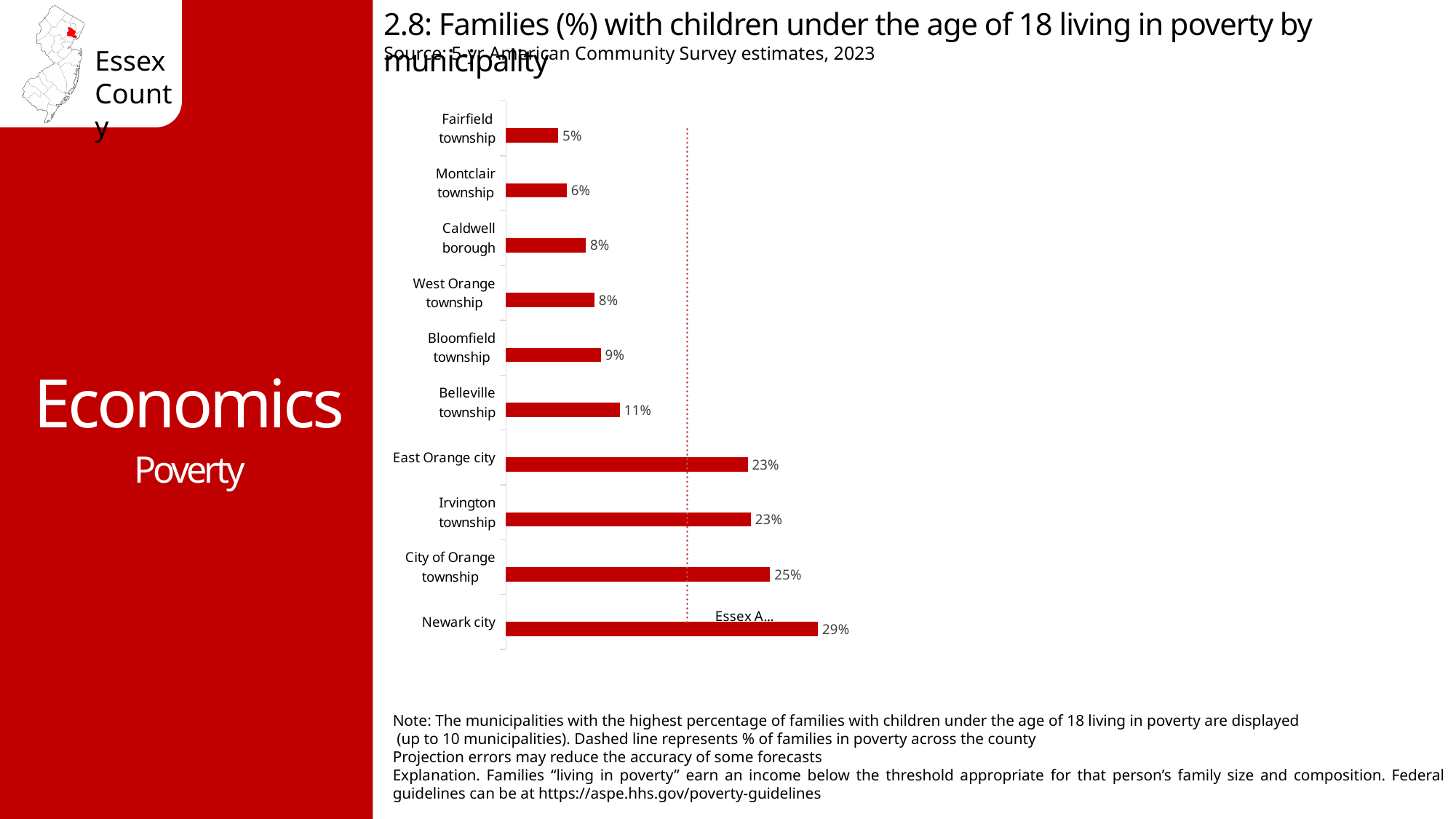
What is the difference between the values for City of Orange township and Bloomfield township? 16% Which municipality has the lowest percentage of families with children under 18 living in poverty? Fairfield township What is the value for Belleville township? 11% What is the value for City of Orange township? 25% How many municipalities are shown in the chart? 10 Which is larger, the value for Belleville township or the value for Caldwell borough? Belleville township What does the dashed vertical line on the chart represent? % of families in poverty across the county What is the value for Montclair township? 6% What is the value for Newark city? 29% Which municipality has the highest percentage of families with children under 18 living in poverty? Newark city What is the difference between the values for Newark city and Fairfield township? 24% What kind of chart is shown on the slide? Bar chart